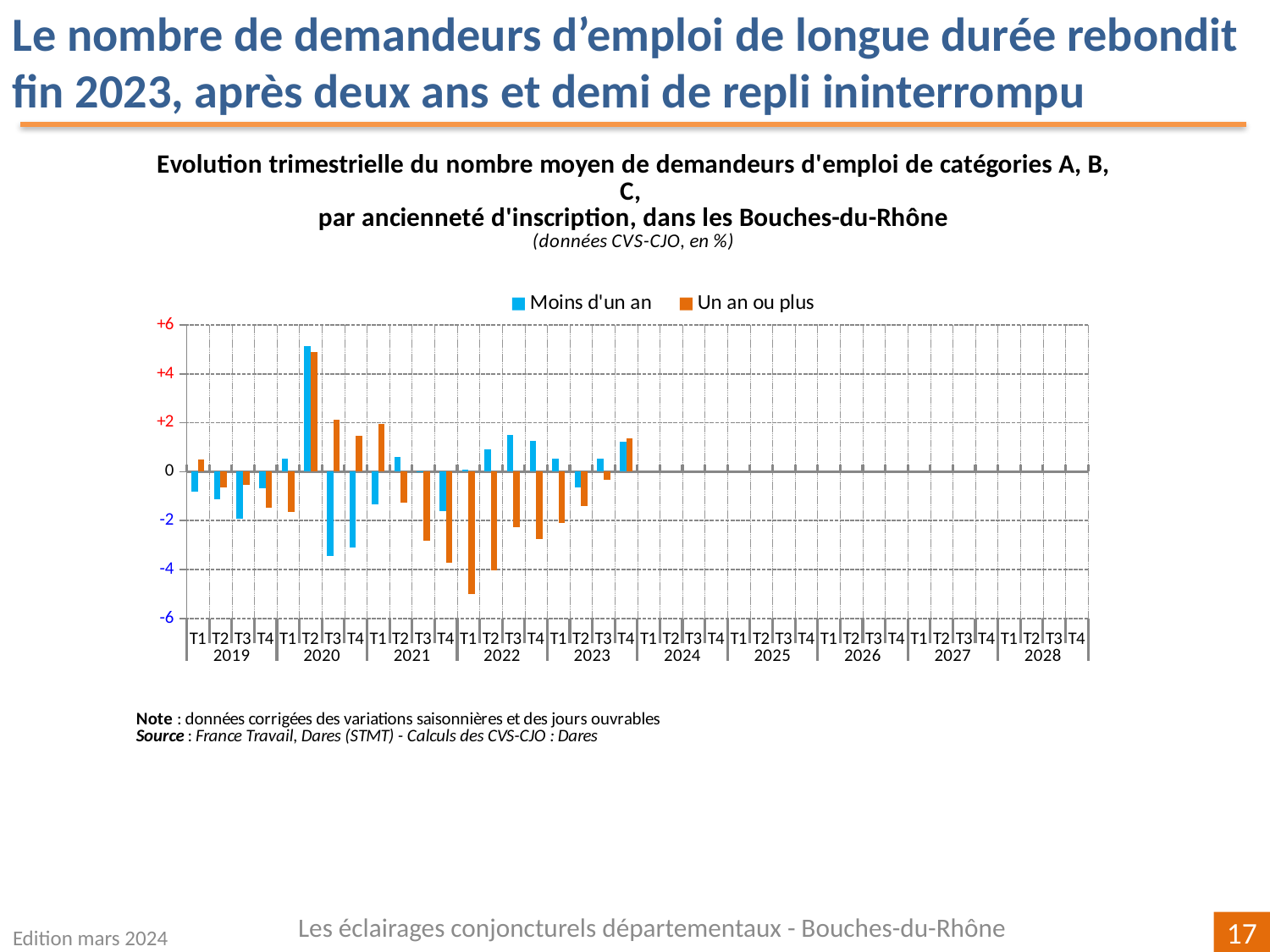
In which quarter does the series "Un an ou plus" reach its lowest value? T1 2022 Is the value for "Un an ou plus" in T2 2020 greater or less than +4? greater In which quarter does the series "Un an ou plus" reach its highest value? T2 2020 What are the two series named in the legend? Moins d'un an; Un an ou plus In which quarter does the series "Moins d'un an" reach its highest value? T2 2020 How many years are labelled along the x axis? 10 Is the value for "Moins d'un an" in T3 2020 greater or less than -2? less In T3 2022, which series has the larger value, "Moins d'un an" or "Un an ou plus"? Moins d'un an How many series does the legend list? 2 Which colour represents the series "Un an ou plus"? orange Is the value for "Un an ou plus" in T1 2022 greater or less than -4? less What kind of chart is shown on the slide? bar chart